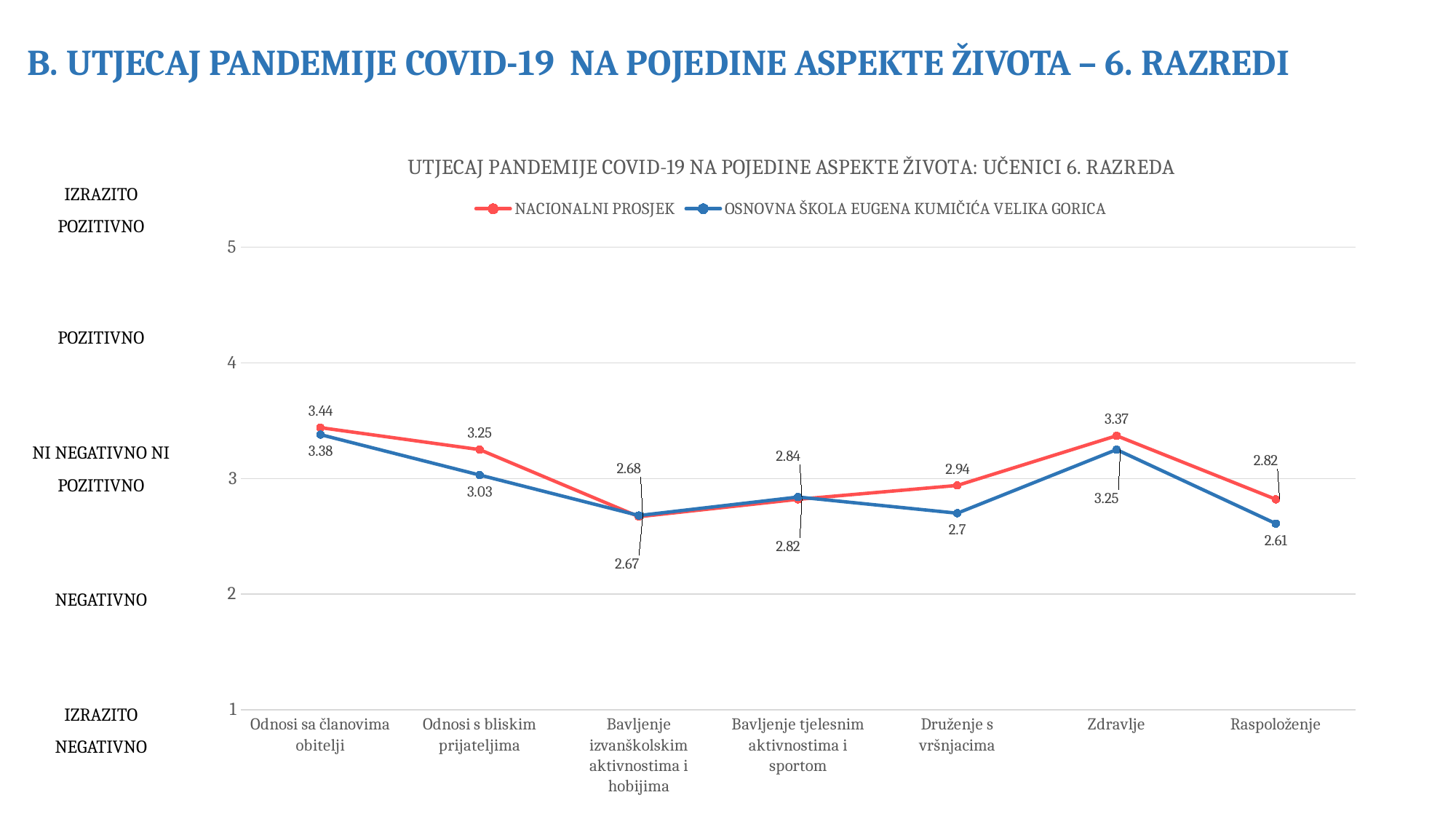
Which category has the lowest value for OSNOVNA ŠKOLA EUGENA KUMIČIĆA VELIKA GORICA? Raspoloženje How many series does the legend list? 2 What is the NACIONALNI PROSJEK value for Zdravlje? 3.37 What is the value for OSNOVNA ŠKOLA EUGENA KUMIČIĆA VELIKA GORICA for Druženje s vršnjacima? 2.7 What is the difference between the NACIONALNI PROSJEK and the OSNOVNA ŠKOLA EUGENA KUMIČIĆA VELIKA GORICA values for Zdravlje? 0.12 What is the NACIONALNI PROSJEK value for Odnosi sa članovima obitelji? 3.44 Which category has the highest NACIONALNI PROSJEK value? Odnosi sa članovima obitelji What is the value for OSNOVNA ŠKOLA EUGENA KUMIČIĆA VELIKA GORICA for Raspoloženje? 2.61 What kind of chart is shown on the slide? Line chart How many categories are shown on the x axis? 7 Is the OSNOVNA ŠKOLA EUGENA KUMIČIĆA VELIKA GORICA value for Odnosi s bliskim prijateljima greater or less than 4? less For Druženje s vršnjacima, which series has the larger value: NACIONALNI PROSJEK or OSNOVNA ŠKOLA EUGENA KUMIČIĆA VELIKA GORICA? NACIONALNI PROSJEK